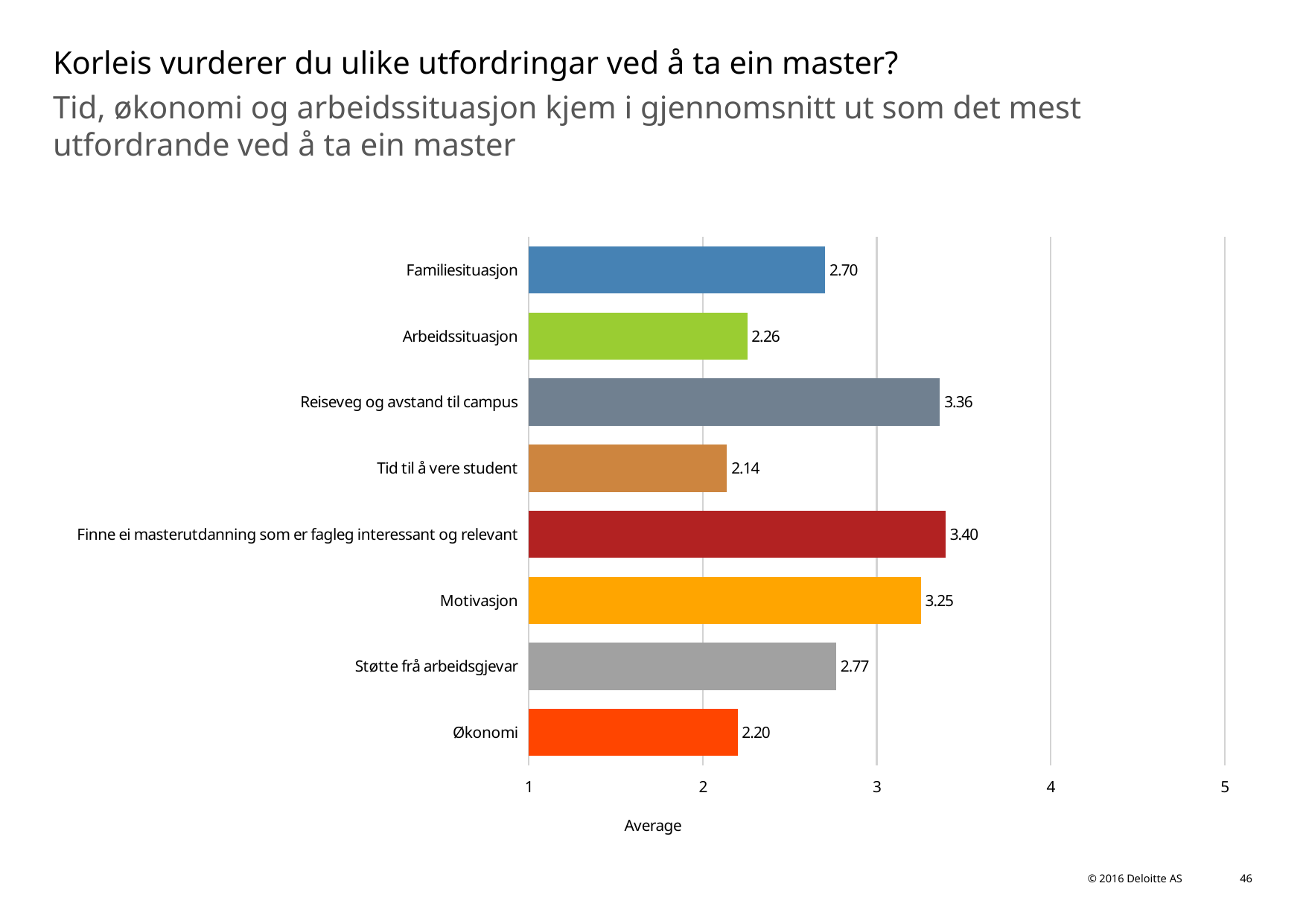
Which category has the highest average value? Finne ei masterutdanning som er fagleg interessant og relevant What colour is the bar for Motivasjon? Yellow/orange What kind of chart is shown on the slide? Bar chart What is the label on the horizontal axis of the chart? Average What is the difference between the values for Motivasjon and Arbeidssituasjon? 0.99 How many categories are shown in the chart? 8 What is the average value for Reiseveg og avstand til campus? 3.36 What is the average value for Familiesituasjon? 2.70 What is the average value for Økonomi? 2.20 Which has a larger value, Støtte frå arbeidsgjevar or Familiesituasjon? Støtte frå arbeidsgjevar Is the value for Motivasjon greater or less than 3? greater Which category has the lowest average value? Tid til å vere student